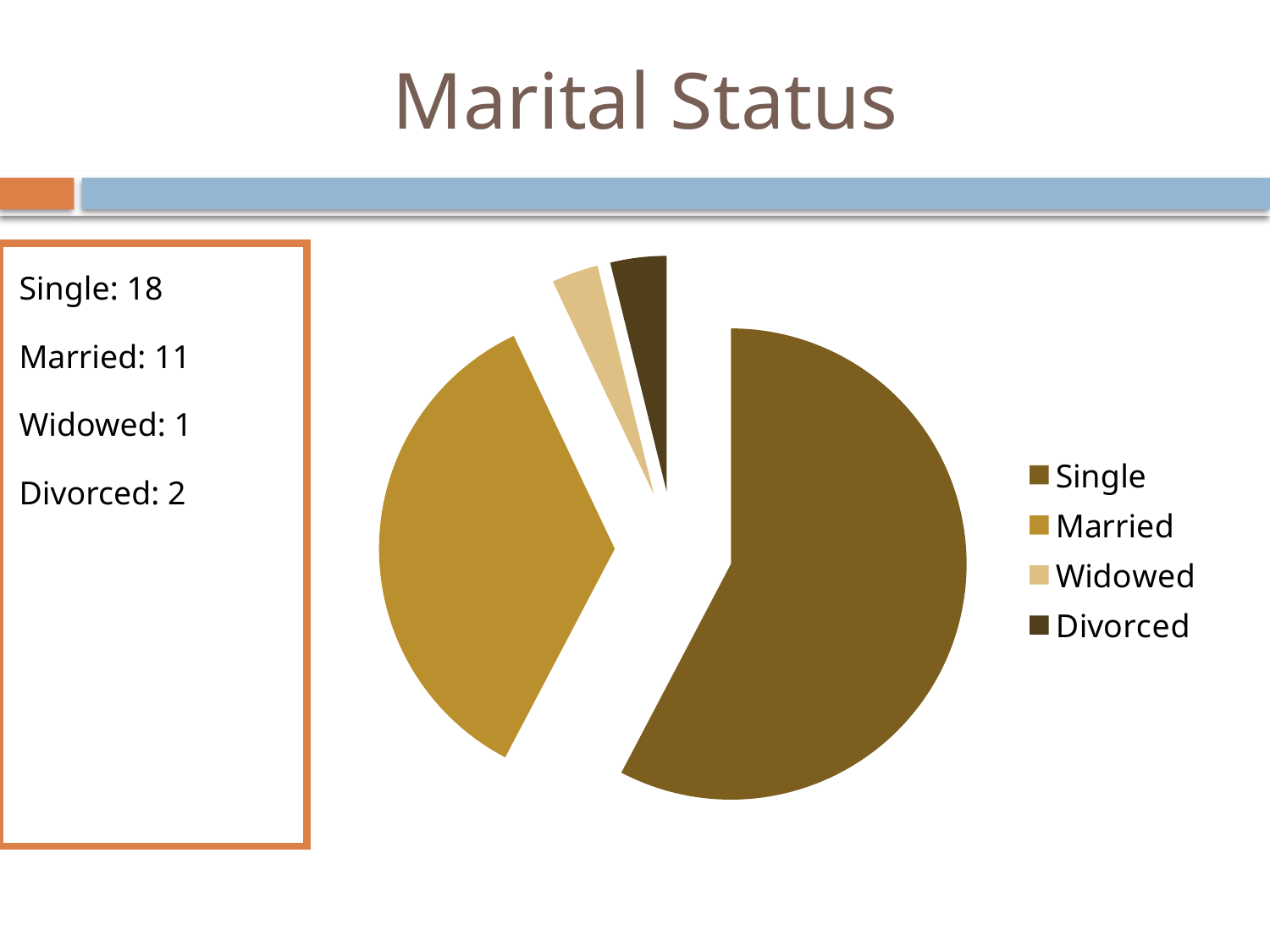
What is the value for Married? 11 What is the value for Widowed? 1 What is the value for Divorced? 2 Which marital status category has the largest slice? Single What is the title of the slide containing the chart? Marital Status How many categories does the pie chart have? 4 Which marital status category has the smallest slice? Widowed What is the value for Single? 18 What is the total of all four categories? 32 What type of chart is shown on the slide? Pie chart Which is larger, Divorced or Widowed? Divorced What is the difference between the Single and Married values? 7